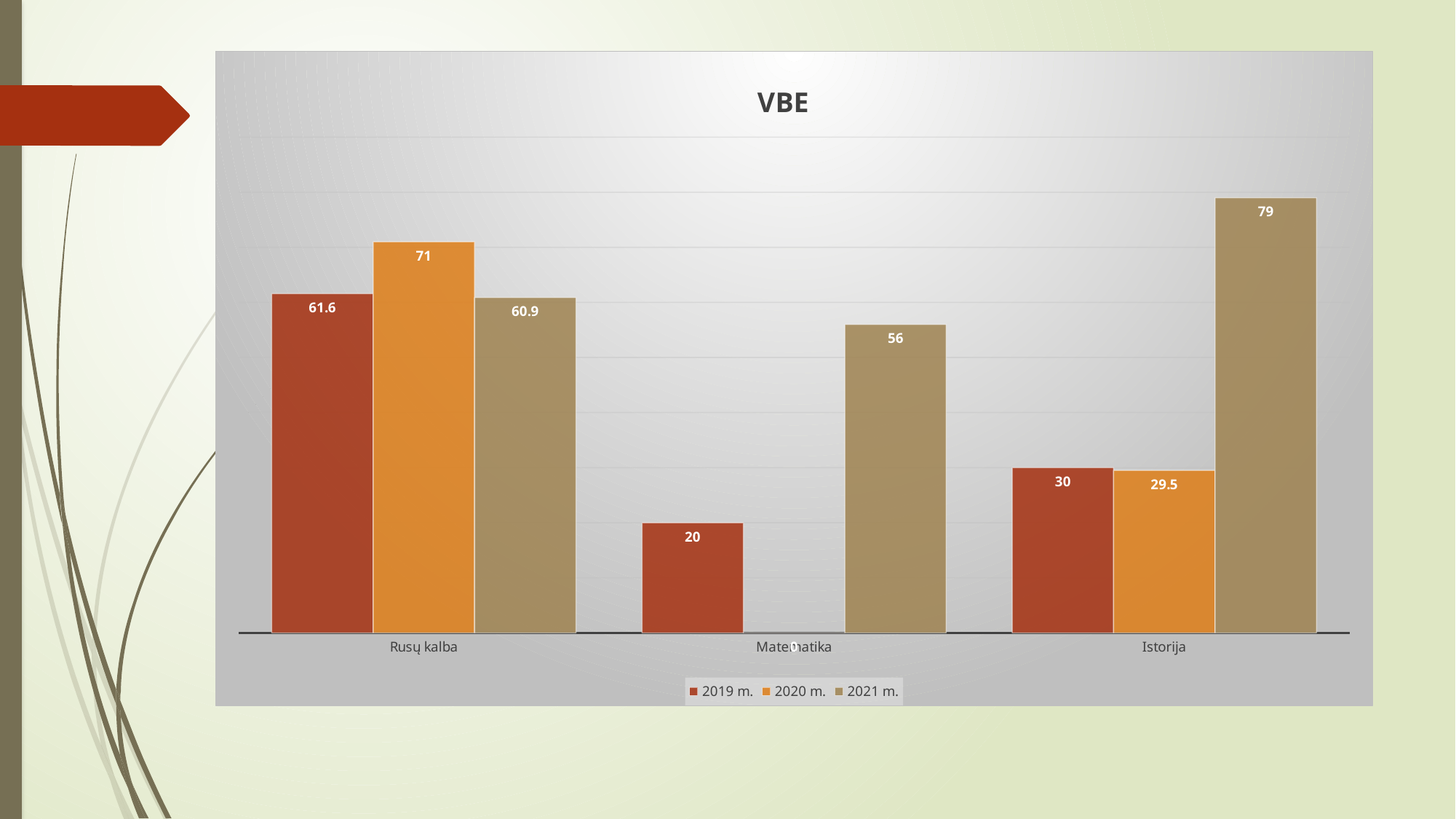
What is the difference between the 2020 m. and 2019 m. values for Rusų kalba? 9.4 What is the value for Istorija in the 2020 m. series? 29.5 Which is larger for Matematika: the 2019 m. value or the 2021 m. value? 2021 m. What is the value for Rusų kalba in the 2019 m. series? 61.6 What is the difference between the 2021 m. and 2019 m. values for Istorija? 49 What type of chart is shown on the slide? Bar chart How many categories are shown on the x axis? 3 How many series does the legend list? 3 Which category has the lowest value in the 2019 m. series? Matematika What is the value for Rusų kalba in the 2020 m. series? 71 Which category has the highest value in the 2021 m. series? Istorija What is the value for Matematika in the 2021 m. series? 56